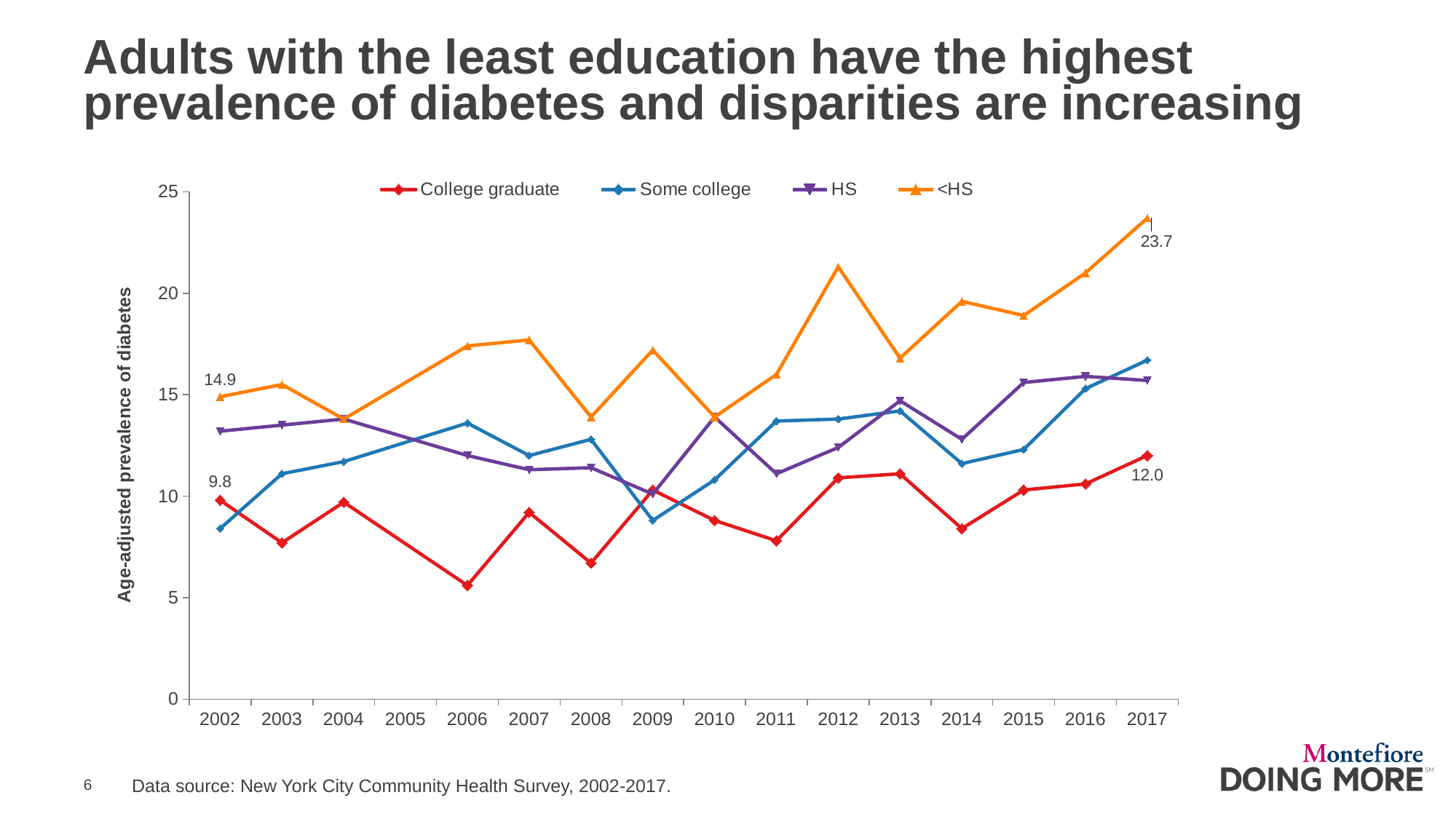
By how much did the <HS value increase from 2002 to 2017? 8.8 How many years are shown on the x axis? 16 What is the value for College graduate in 2002? 9.8 Does the <HS series rise or fall overall from 2002 to 2017? rise What is the value for <HS in 2002? 14.9 How many series does the legend list? 4 Is the value for Some college in 2002 greater or less than 10? less What kind of chart is shown on the slide? line chart What is the difference between the <HS value and the College graduate value in 2017? 11.7 What is the y-axis title of the chart? Age-adjusted prevalence of diabetes What is the value for <HS in 2017? 23.7 Which series has the highest value in 2017? <HS